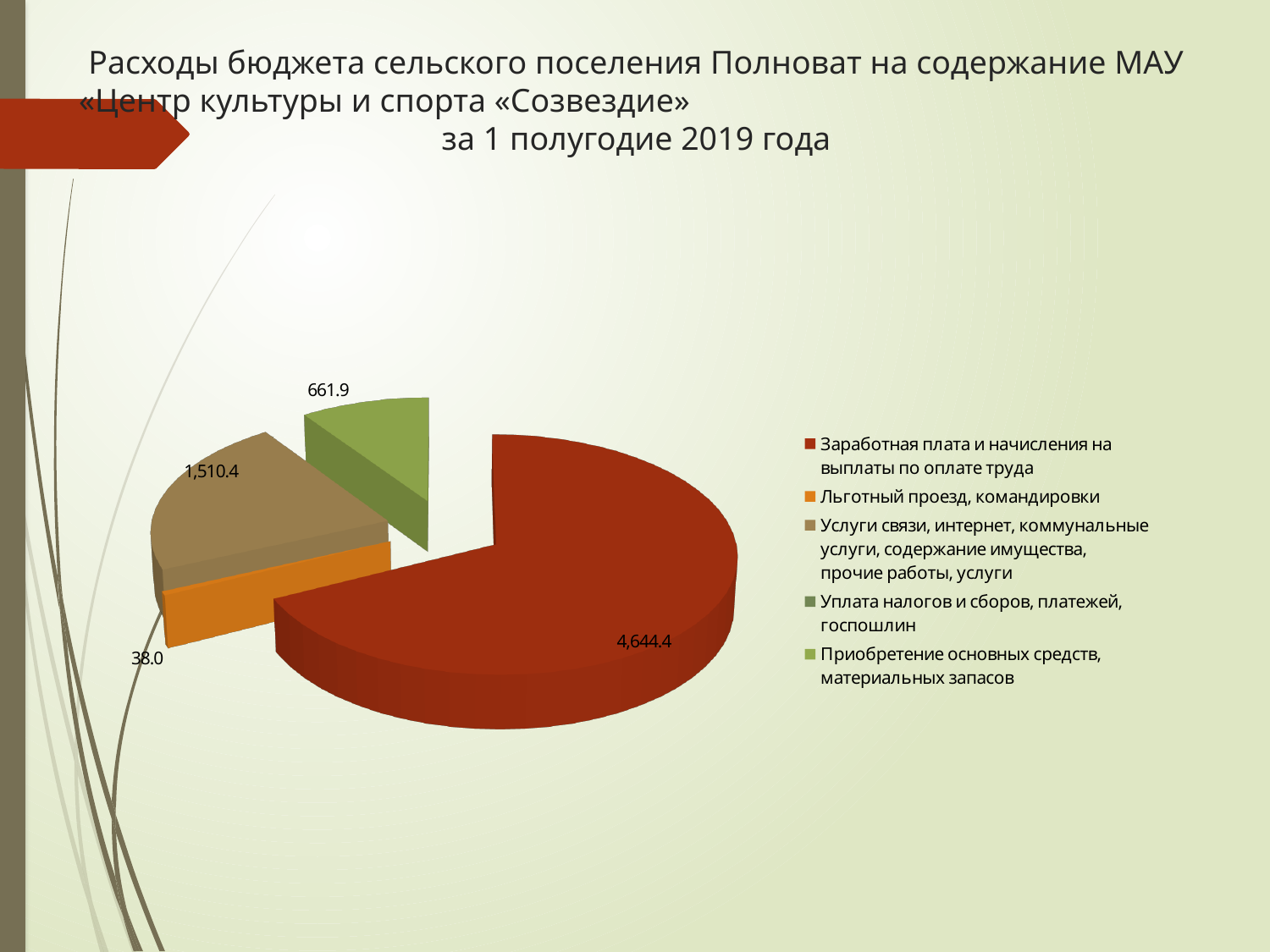
What colour is the slice for «Заработная плата и начисления на выплаты по оплате труда»? Red What is the value for «Услуги связи, интернет, коммунальные услуги, содержание имущества, прочие работы, услуги»? 1,510.4 What type of chart is shown on the slide? Pie chart What is the value for «Приобретение основных средств, материальных запасов»? 661.9 Which category has the largest slice of the pie? Заработная плата и начисления на выплаты по оплате труда What is the difference between the values for «Заработная плата и начисления на выплаты по оплате труда» and «Услуги связи, интернет, коммунальные услуги, содержание имущества, прочие работы, услуги»? 3,134.0 How many entries does the legend list? 5 What is the value for «Заработная плата и начисления на выплаты по оплате труда»? 4,644.4 Which is larger: the value for «Приобретение основных средств, материальных запасов» or for «Льготный проезд, командировки»? Приобретение основных средств, материальных запасов Which labelled slice has the smallest value? Льготный проезд, командировки What is the difference between the values for «Услуги связи, интернет, коммунальные услуги, содержание имущества, прочие работы, услуги» and «Приобретение основных средств, материальных запасов»? 848.5 What is the value for «Льготный проезд, командировки»? 38.0